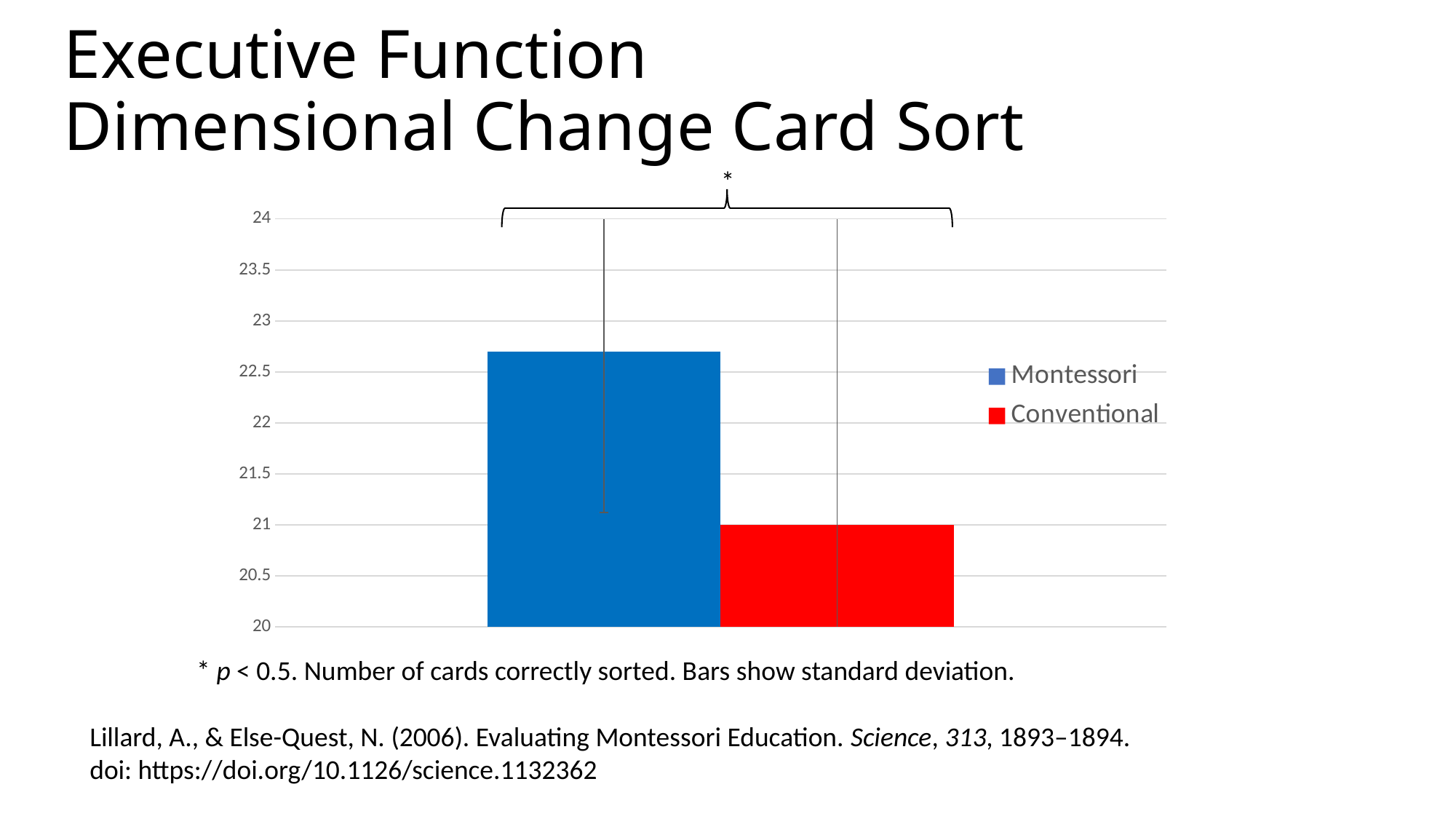
Which series has the lowest bar? Conventional Is the value for Montessori greater or less than 23? less How many bars are plotted in the chart? 2 Which series has the higher value, Montessori or Conventional? Montessori What is the value of the Conventional bar? 21 How many series does the legend list? 2 Is the value for Montessori greater or less than 22.5? greater Is the value for Conventional greater or less than 22? less What is the maximum value shown on the vertical axis? 24 Which series has the highest bar? Montessori What kind of chart is shown on the slide? bar chart What colour is the Montessori bar? blue